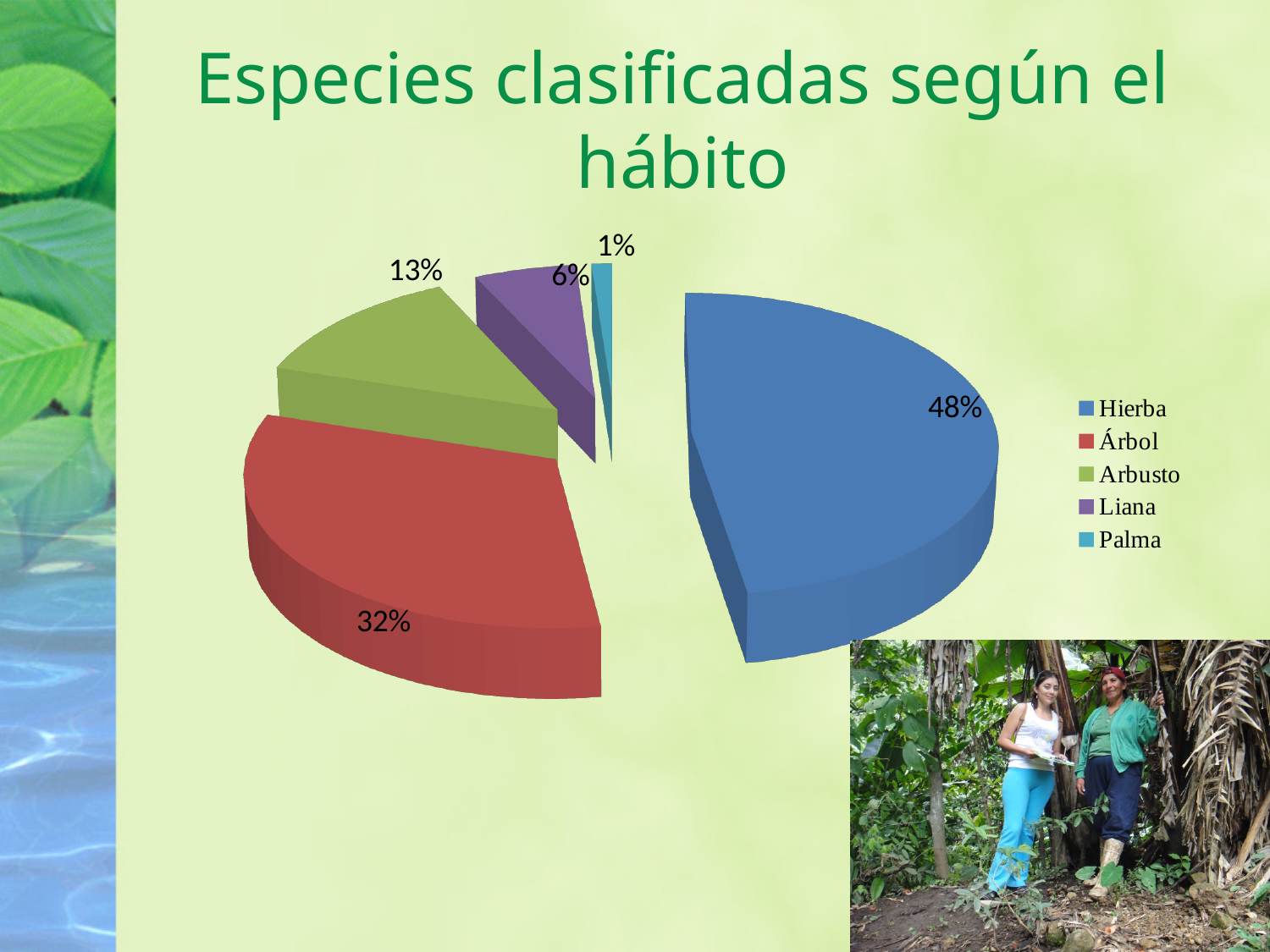
What kind of chart is shown on the slide? Pie chart What colour is the Árbol slice in the pie chart? Red What share of the pie does Hierba represent? 48% Which category has the smallest slice of the pie? Palma What share of the pie does Liana represent? 6% Which is larger, the share for Arbusto or the share for Liana? Arbusto What is the difference in percentage points between Hierba and Árbol? 16% What share of the pie does Arbusto represent? 13% How many categories does the pie chart show? 5 Which category has the largest slice of the pie? Hierba